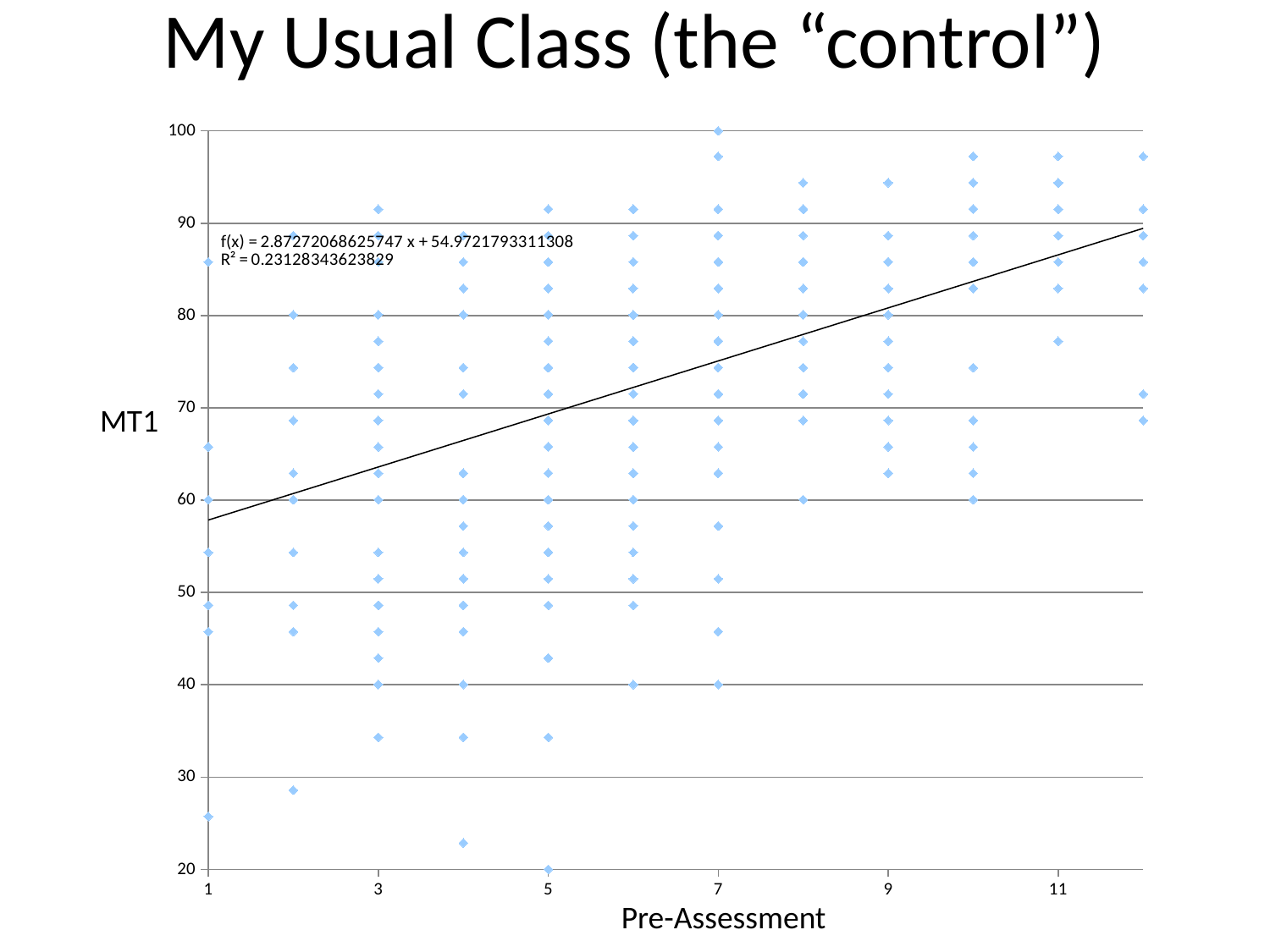
What is the label of the x axis? Pre-Assessment At which Pre-Assessment score does the single lowest MT1 point appear? 5 What is the title of the chart? My Usual Class (the "control") What is the slope of the trendline equation shown on the chart? 2.87272068625747 According to the trendline, do MT1 values rise or fall as Pre-Assessment increases? rise What is the highest MT1 value plotted at Pre-Assessment 7? 100 Is the lowest MT1 value at Pre-Assessment 4 greater or less than 30? less Is the lowest MT1 value at Pre-Assessment 12 greater or less than 60? greater At which Pre-Assessment score does the single highest MT1 point appear? 7 What is the R² value shown for the trendline? 0.23128343623829 What kind of chart is shown on the slide? scatter chart What is the lowest MT1 value plotted at Pre-Assessment 5? 20